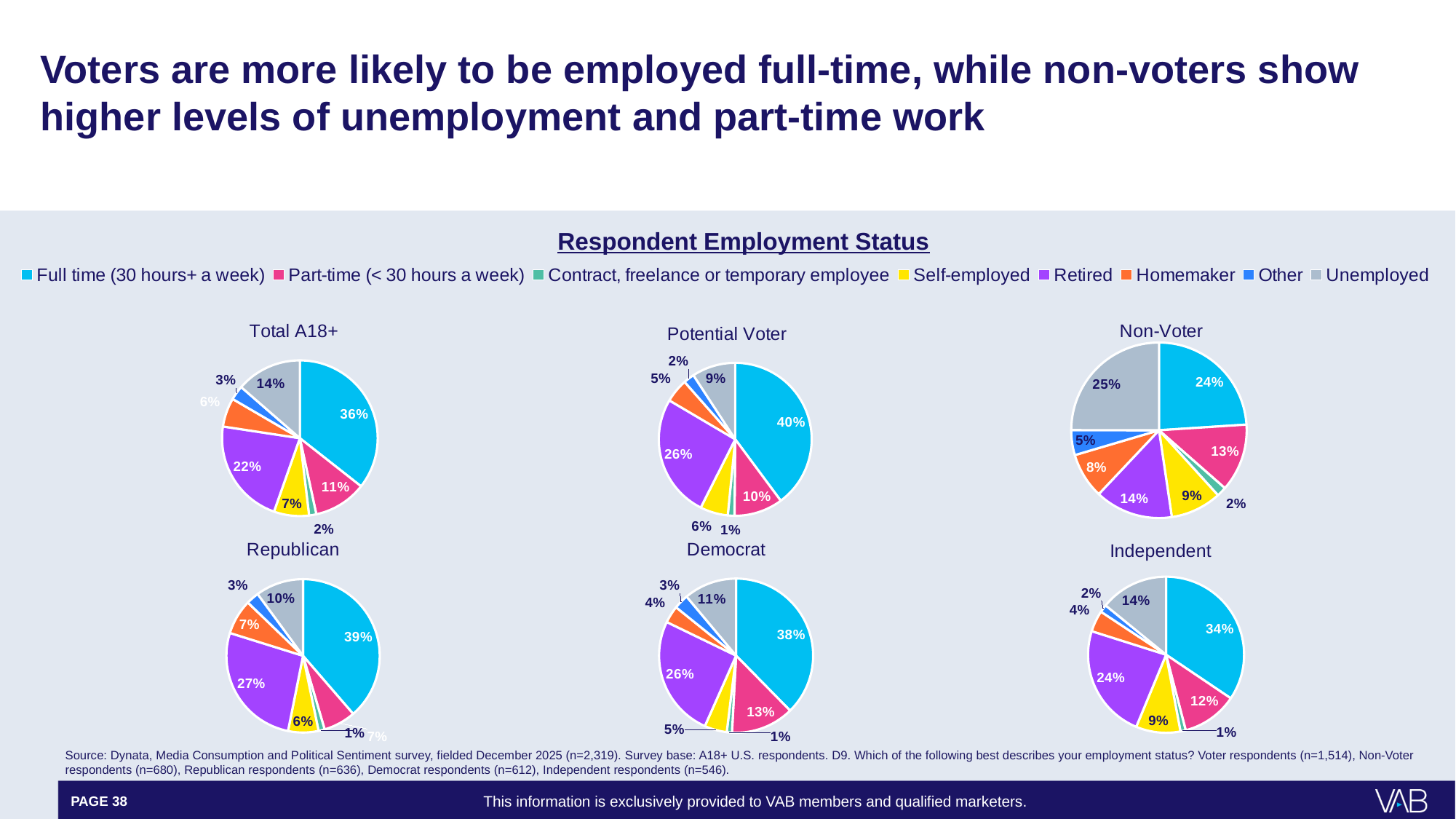
What is the title shown above the group of pie charts? Respondent Employment Status How many employment status categories does the legend list? 8 In the Total A18+ pie chart, what share of respondents are employed full time (30 hours+ a week)? 36% In the Non-Voter pie chart, what share of respondents are unemployed? 25% What kind of charts are shown on the slide? Pie charts In the Independent pie chart, what share of respondents are self-employed? 9% Which is larger: the unemployed share in the Non-Voter pie chart or the unemployed share in the Potential Voter pie chart? Non-Voter In the Democrat pie chart, what is the share for Part-time (< 30 hours a week)? 13% In the Republican pie chart, what is the share for Homemaker? 7% In the Potential Voter pie chart, what share of respondents are retired? 26% What is the difference between the full-time share in the Potential Voter pie chart and the full-time share in the Non-Voter pie chart? 16% In the Republican pie chart, which employment status has the largest share? Full time (30 hours+ a week)